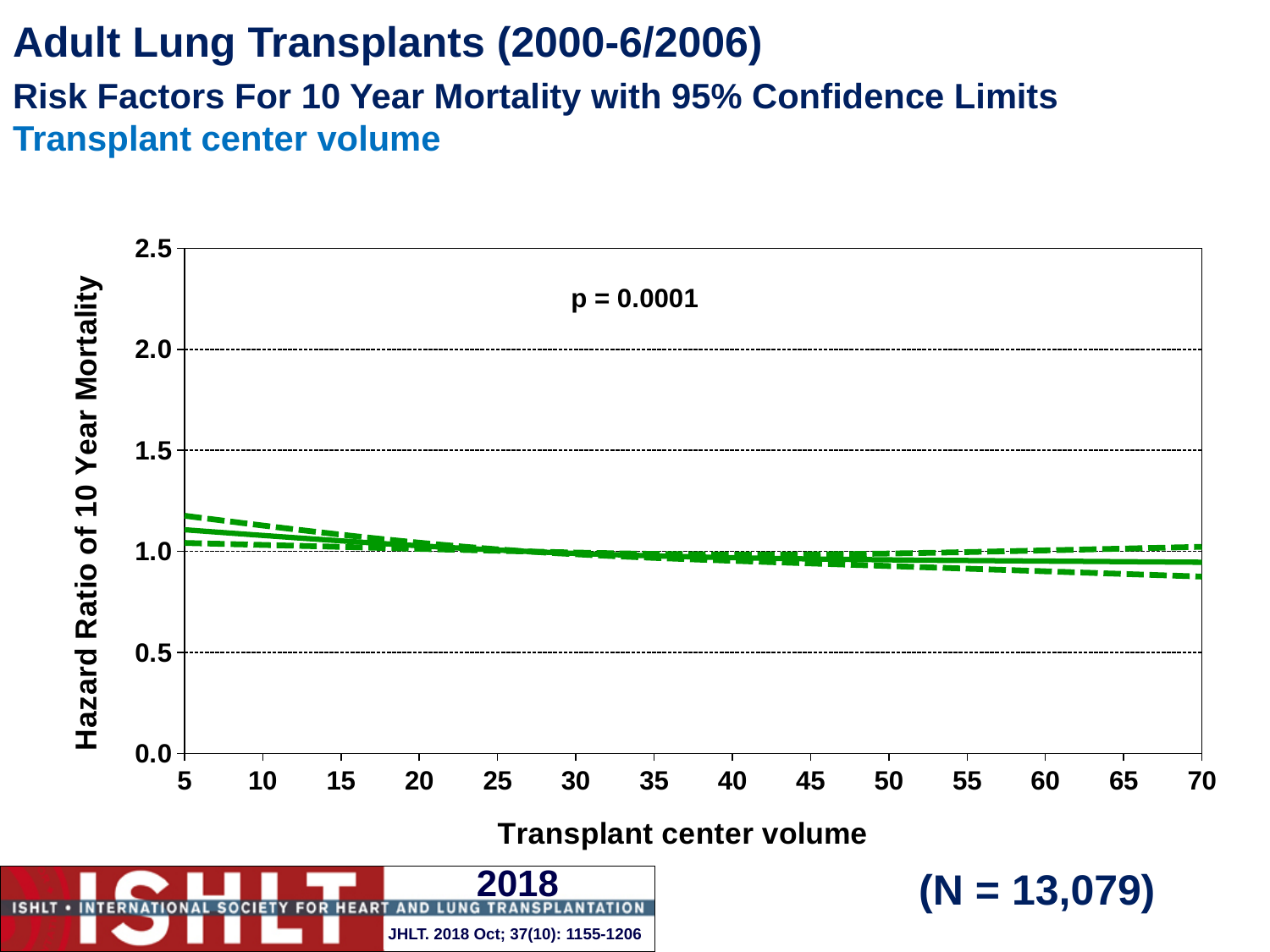
Is the hazard ratio at a transplant center volume of 5 greater or less than 1.5? less What kind of chart is shown on the slide? line chart What is the highest value labelled on the y axis? 2.5 Is the upper 95% confidence limit at a transplant center volume of 70 greater or less than 1.5? less How many tick labels are shown on the x axis? 14 Does the hazard ratio (solid line) rise or fall as transplant center volume increases from 5 to 70? fall What is the title of the x axis? Transplant center volume Is the hazard ratio at a transplant center volume of 5 greater or less than 1.0? greater What is the title of the y axis? Hazard Ratio of 10 Year Mortality What p-value is printed on the chart? p = 0.0001 What is the sample size (N) shown on the slide? N = 13,079